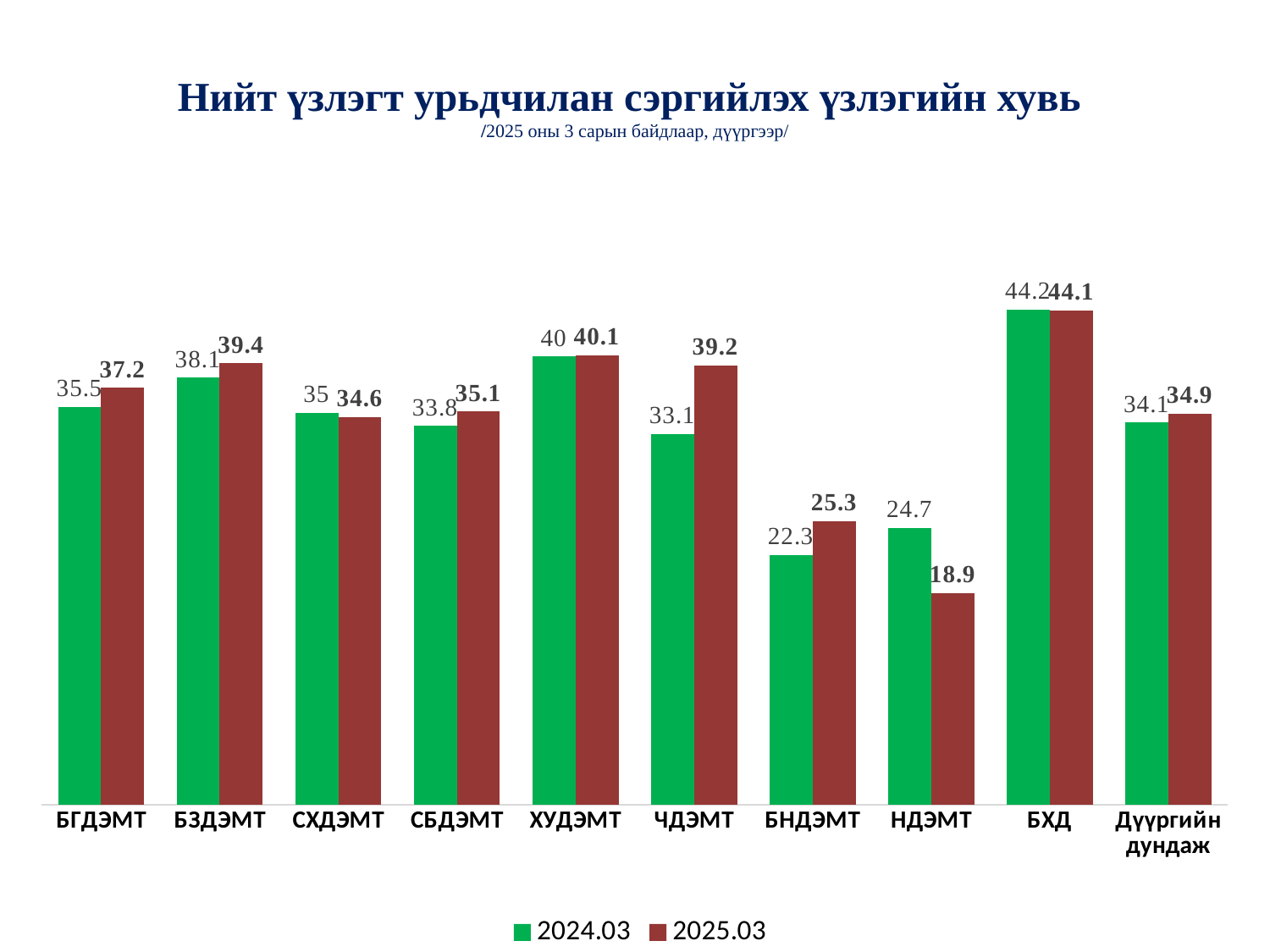
What is the value for ЧДЭМТ in the 2025.03 series? 39.2 How many series does the legend list? 2 What is the 2025.03 value for Дүүргийн дундаж? 34.9 Which category has the lowest value in the 2025.03 series? НДЭМТ What is the difference between the 2025.03 and 2024.03 values for ЧДЭМТ? 6.1 What is the difference between the 2024.03 and 2025.03 values for НДЭМТ? 5.8 Which category has the highest value in the 2025.03 series? БХД What is the value for НДЭМТ in the 2024.03 series? 24.7 Which category has the lowest value in the 2024.03 series? БНДЭМТ For БНДЭМТ, which is larger: the 2024.03 value or the 2025.03 value? 2025.03 How many categories are shown on the x axis? 10 What kind of chart is shown on the slide? Bar chart